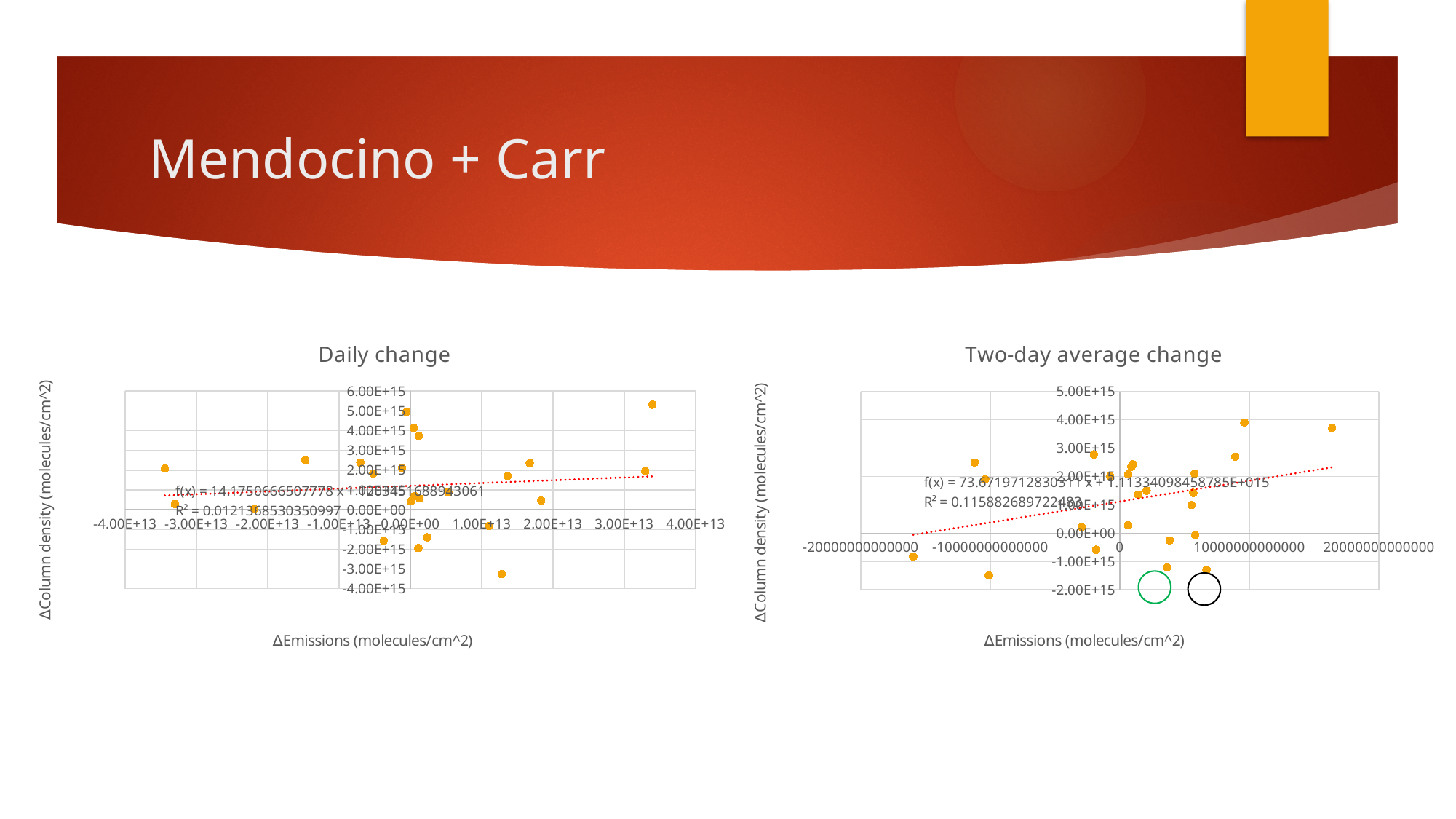
In the "Daily change" chart, does the dotted trendline rise or fall as ΔEmissions increases? rise In the "Daily change" chart, what is the slope (coefficient of x) in the trendline equation? 14.1750666507778 What is the x-axis label of the "Daily change" chart? ΔEmissions (molecules/cm^2) In the "Two-day average change" chart, what R² value is shown for the trendline? 0.115882689722483 In the "Two-day average change" chart, what is the intercept term in the trendline equation? 1.11334098458785E+015 In the "Two-day average change" chart, what is the slope (coefficient of x) in the trendline equation? 73.6719712830311 What is the title of the chart on the right side of the slide? Two-day average change In the "Daily change" chart, what R² value is shown for the trendline? 0.0121368530350997 Which chart has the higher R² value, "Daily change" or "Two-day average change"? Two-day average change In the "Two-day average change" chart, does the dotted trendline rise or fall as ΔEmissions increases? rise How many charts are shown on the slide? 2 What kind of chart is the "Daily change" chart? scatter chart